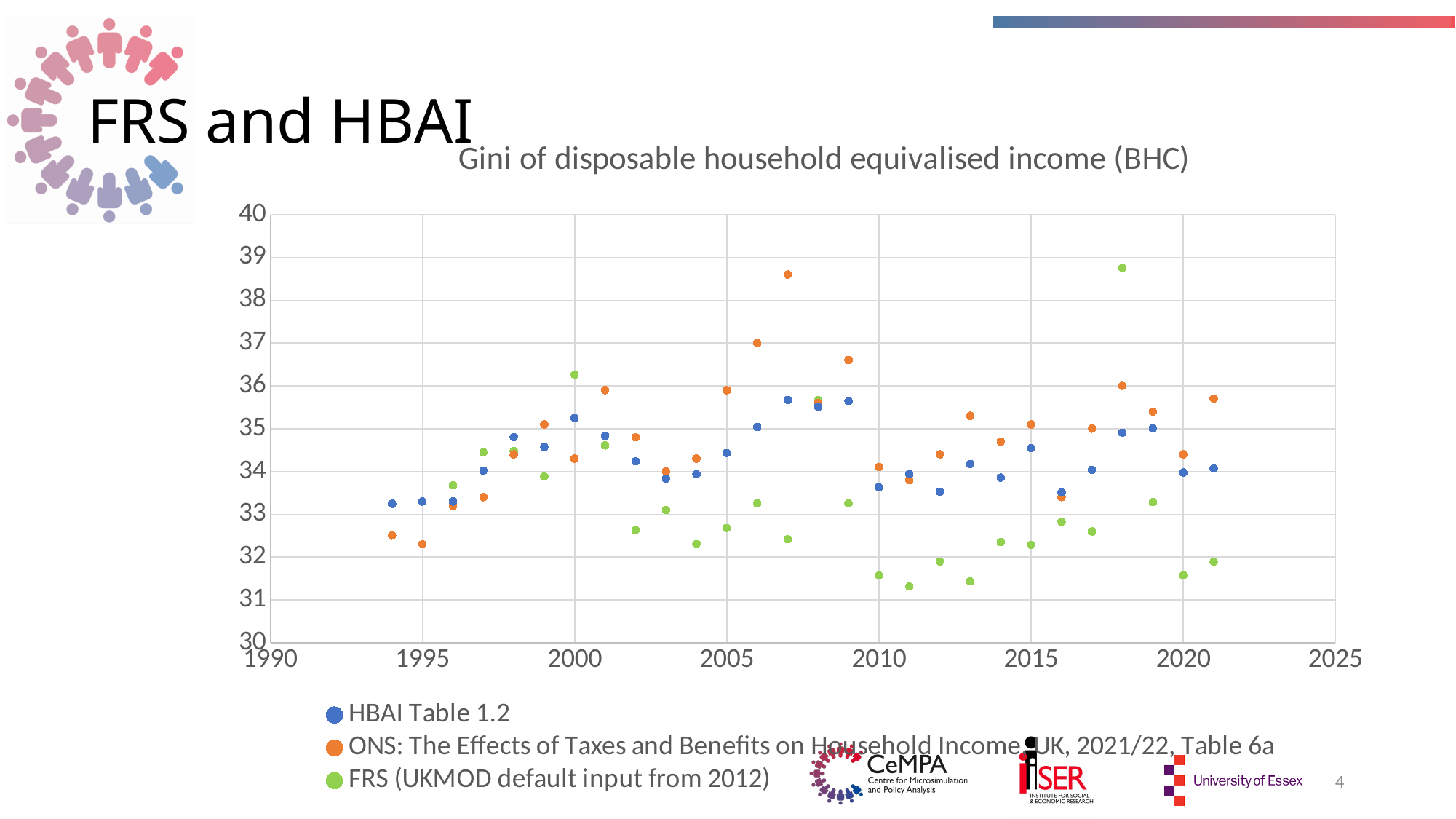
Is the FRS value for 2000 greater or less than 36? greater What kind of chart is shown on the slide? Scatter chart Is the ONS value for 2007 greater or less than 38? greater In 2011, which series has the larger value, HBAI Table 1.2 or FRS? HBAI Table 1.2 How many series does the legend list? 3 Is the ONS value for 1995 greater or less than 33? less What is the title of the chart? Gini of disposable household equivalised income (BHC) In which year does the FRS series reach its highest value? 2018 Which colour represents the FRS (UKMOD default input from 2012) series? Green In 2007, which series has the larger value, HBAI Table 1.2 or ONS? ONS